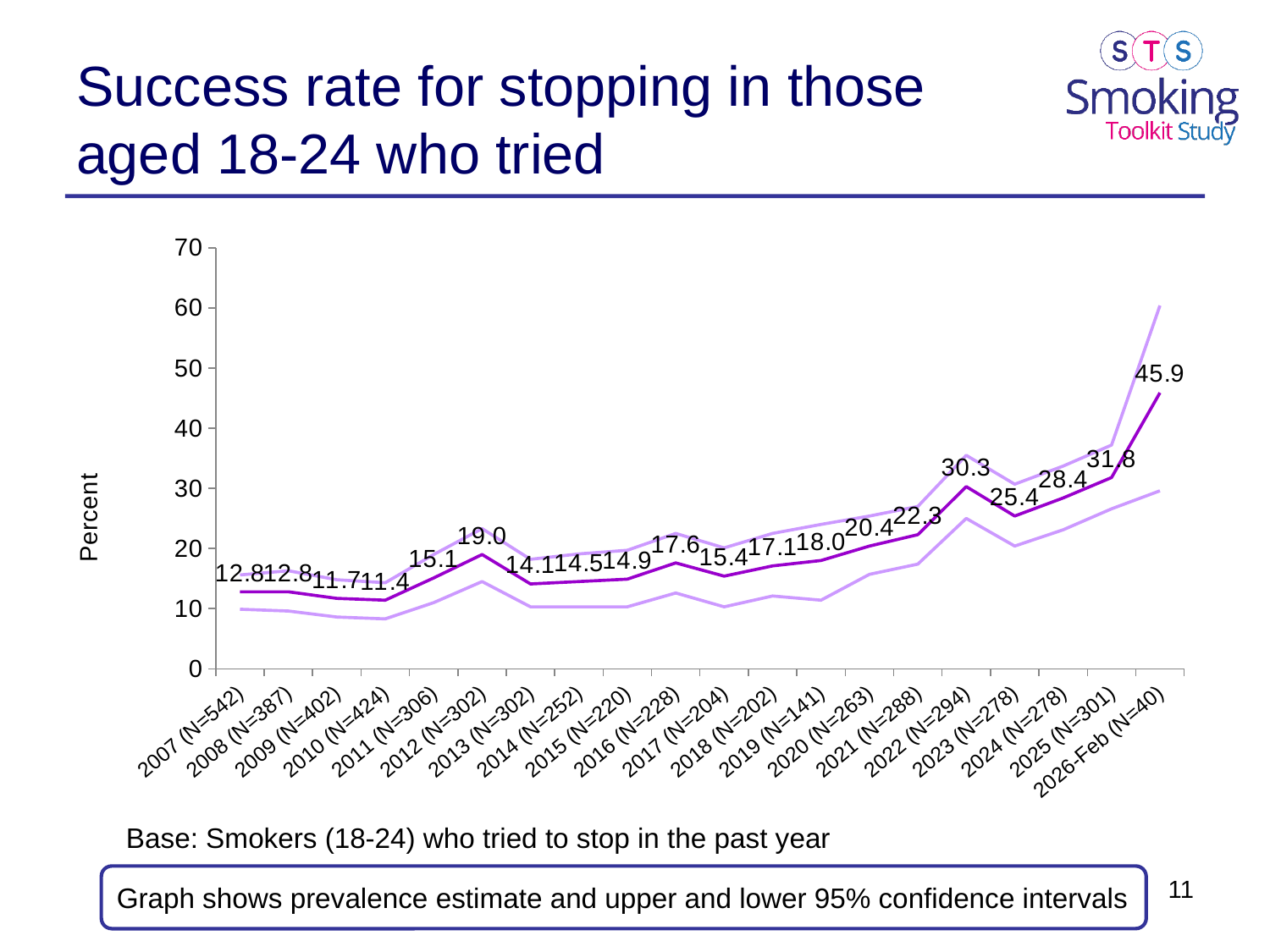
Which year has the lowest success rate? 2010 (N=424) Which year has a higher success rate, 2022 (N=294) or 2023 (N=278)? 2022 (N=294) Which year has the highest success rate? 2026-Feb (N=40) How many years (data points) are plotted on the x axis? 20 What kind of chart is shown on the slide? Line chart What is the difference between the success rate for 2022 (N=294) and 2021 (N=288)? 8.0 What is the success rate for 2022 (N=294)? 30.3 What is the difference between the success rate for 2026-Feb (N=40) and 2025 (N=301)? 14.1 Is the upper confidence interval value for 2026-Feb (N=40) greater or less than 50? greater Does the success rate generally rise or fall from 2007 to 2026-Feb? Rise What is the success rate for 2019 (N=141)? 18.0 What is the success rate for 2012 (N=302)? 19.0